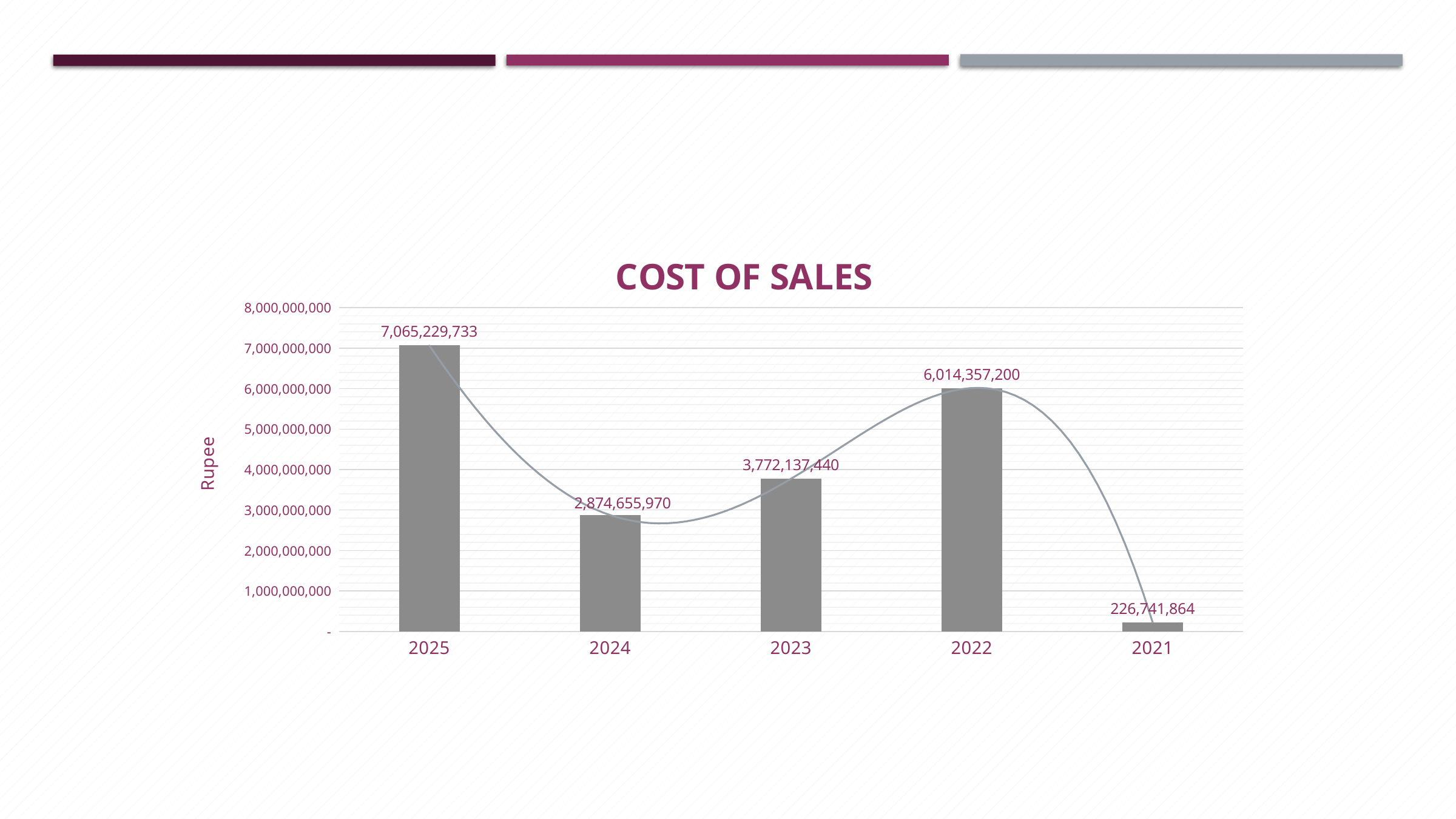
What is the cost of sales for 2022? 6,014,357,200 What is the difference between the cost of sales in 2023 and 2024? 897,481,470 Is the cost of sales for 2022 greater or less than 5,000,000,000? greater What kind of chart is shown on the slide? bar chart What is the cost of sales for 2025? 7,065,229,733 Which year has the lowest cost of sales? 2021 What is the cost of sales for 2023? 3,772,137,440 Which year has a larger cost of sales, 2024 or 2023? 2023 What is the cost of sales for 2021? 226,741,864 How many years are shown on the chart? 5 What is the difference between the cost of sales in 2025 and 2022? 1,050,872,533 Which year has the highest cost of sales? 2025